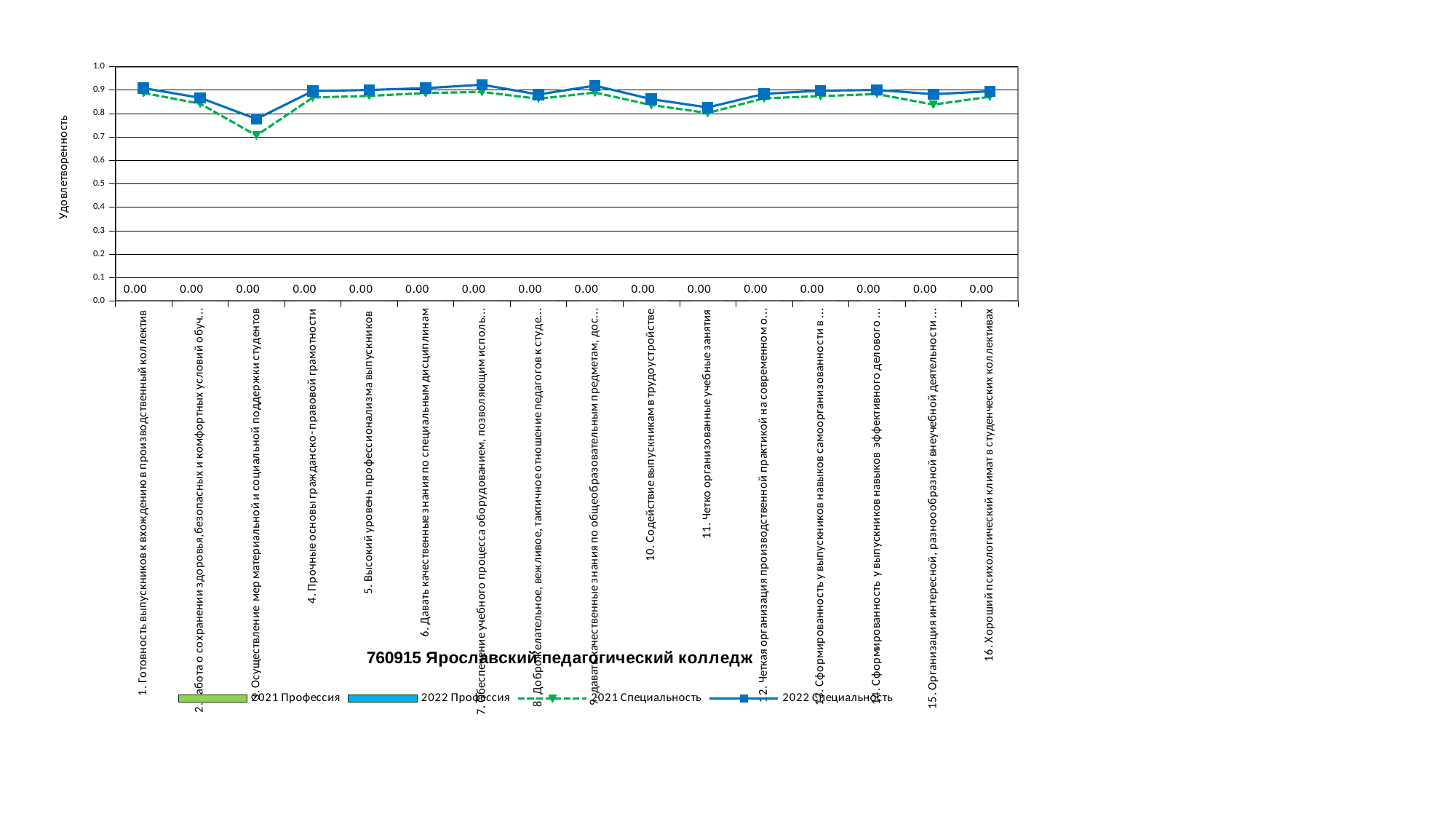
How many categories are shown along the x axis of the chart? 16 What is the label of the vertical axis? Удовлетворенность For the series '2021 Специальность', which category has the lowest value? 3. Осуществление мер материальной и социальной поддержки студентов What value is printed as the data label for the bars at category '16. Хороший психологический климат в студенческих коллективах'? 0.00 How many series does the chart legend list? 4 What value is printed as the data label for the bars at category '1. Готовность выпускников к вхождению в производственный коллектив'? 0.00 Is the value of '2021 Специальность' at category '3. Осуществление мер материальной и социальной поддержки студентов' greater or less than 0.8? less Is the value of '2022 Специальность' at category '11. Четко организованные учебные занятия' greater or less than 0.8? greater At category '3. Осуществление мер материальной и социальной поддержки студентов', which series has the larger value: '2021 Специальность' or '2022 Специальность'? 2022 Специальность For the series '2022 Специальность', which category has the lowest value? 3. Осуществление мер материальной и социальной поддержки студентов What is the title of the chart? 760915 Ярославский педагогический колледж For the series '2022 Специальность', which category has the larger value: '3. Осуществление мер материальной и социальной поддержки студентов' or '11. Четко организованные учебные занятия'? 11. Четко организованные учебные занятия